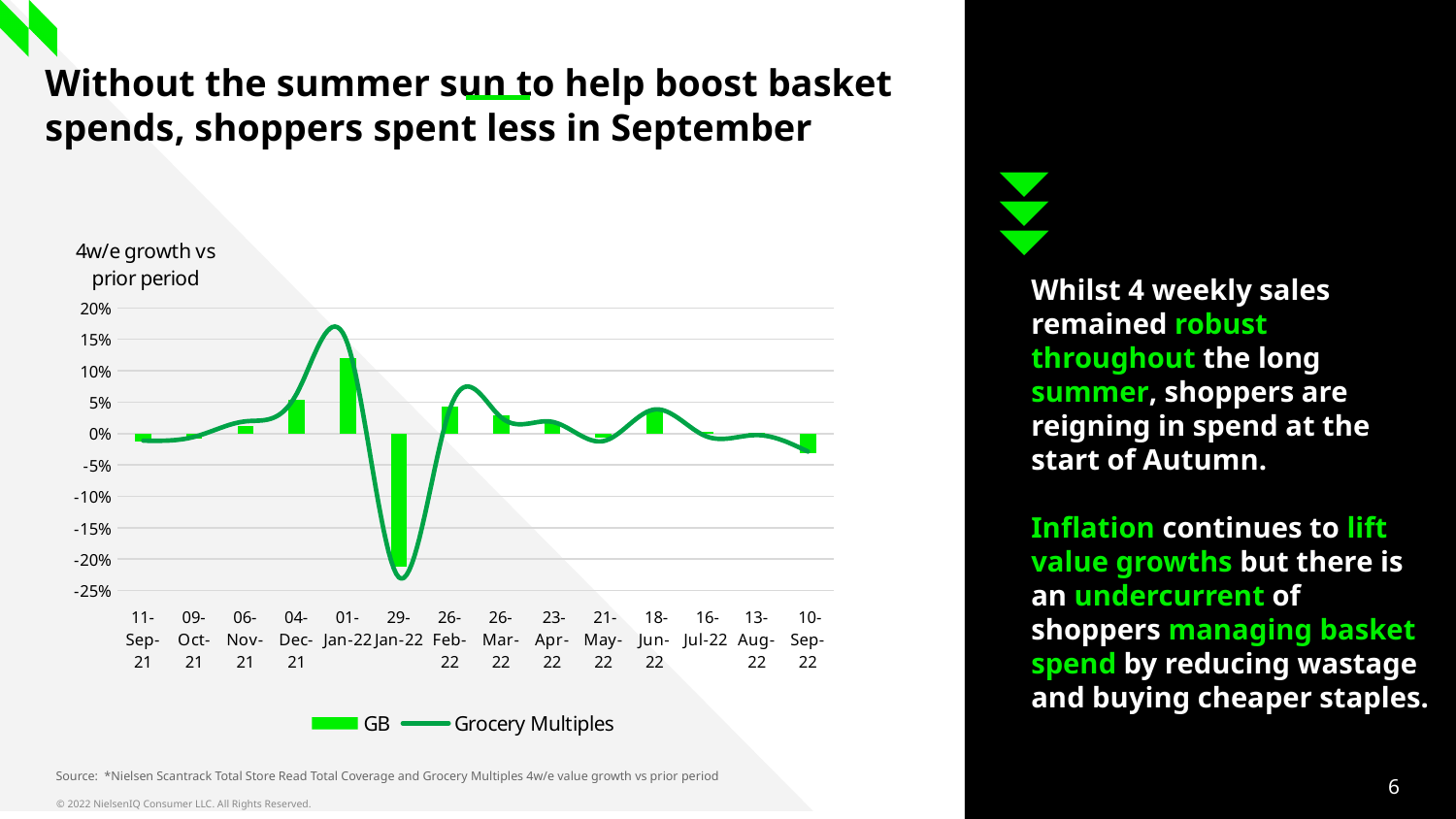
Which series is plotted as bars in the chart? GB What is the title of the chart? 4w/e growth vs prior period Which has the larger GB value, 06-Nov-21 or 04-Dec-21? 04-Dec-21 How many series does the chart legend list? 2 Does the GB value rise or fall from 01-Jan-22 to 29-Jan-22? fall In which period is the GB bar at its lowest? 29-Jan-22 In which period is the GB bar at its highest? 01-Jan-22 Is the GB value for 01-Jan-22 greater or less than 5%? greater What kind of chart is shown on the slide? A combined bar and line chart Is the Grocery Multiples value for 01-Jan-22 greater or less than 10%? greater Is the GB value for 29-Jan-22 greater or less than -10%? less How many time periods are shown on the x axis of the chart? 14